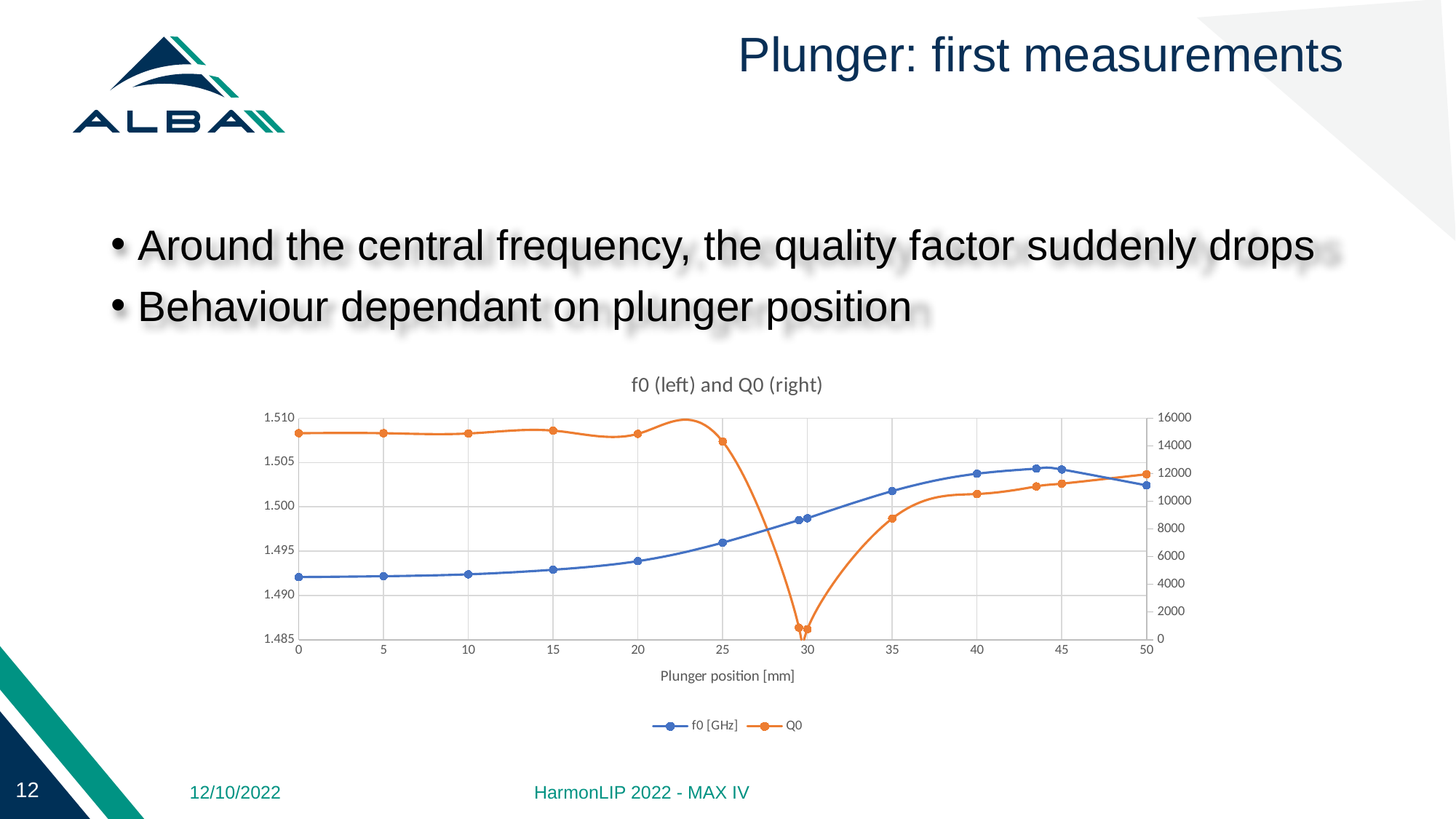
What kind of chart is shown on the slide? Line chart What is the title of the chart? f0 (left) and Q0 (right) Does the f0 [GHz] series generally rise or fall as the plunger position increases from 0 to 40 mm? Rise Which series is plotted in orange? Q0 How many series does the chart legend list? 2 Is the f0 [GHz] value at plunger position 40 mm greater or less than 1.500? greater Is the Q0 value at plunger position 35 mm greater or less than 10000? less Is the f0 [GHz] value at plunger position 0 mm greater or less than 1.495? less What is the label of the x axis of the chart? Plunger position [mm]